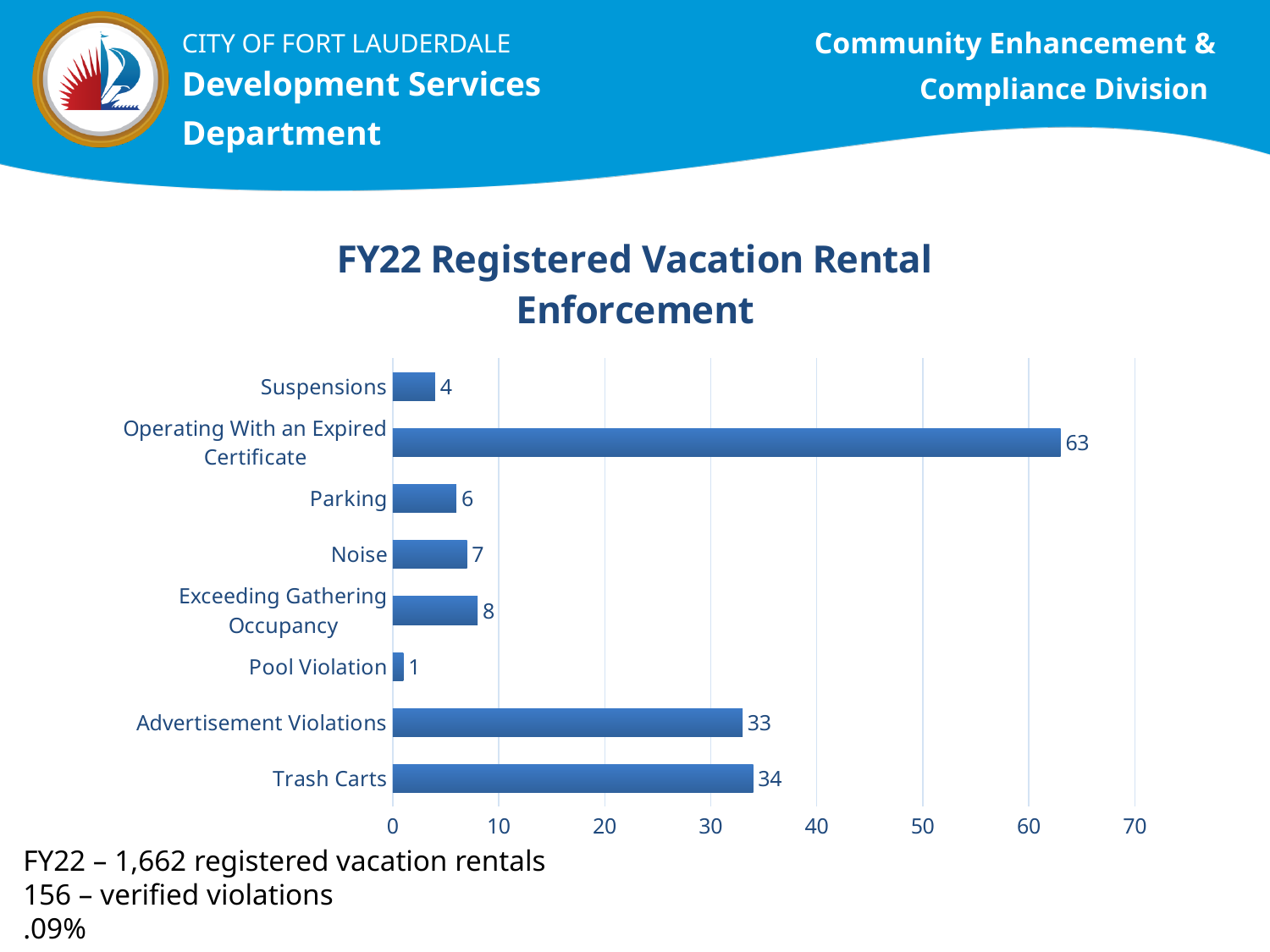
What is the value for Pool Violation? 1 What is the value for Trash Carts? 34 How many categories are shown in the chart? 8 What is the title of the chart? FY22 Registered Vacation Rental Enforcement Is the value for Advertisement Violations greater or less than 30? greater What is the difference between the values for Operating With an Expired Certificate and Trash Carts? 29 Which category has the lowest value? Pool Violation Which is larger, the value for Noise or the value for Parking? Noise What is the value for Exceeding Gathering Occupancy? 8 Which category has the highest value? Operating With an Expired Certificate What is the value for Operating With an Expired Certificate? 63 What kind of chart is shown on the slide? Bar chart